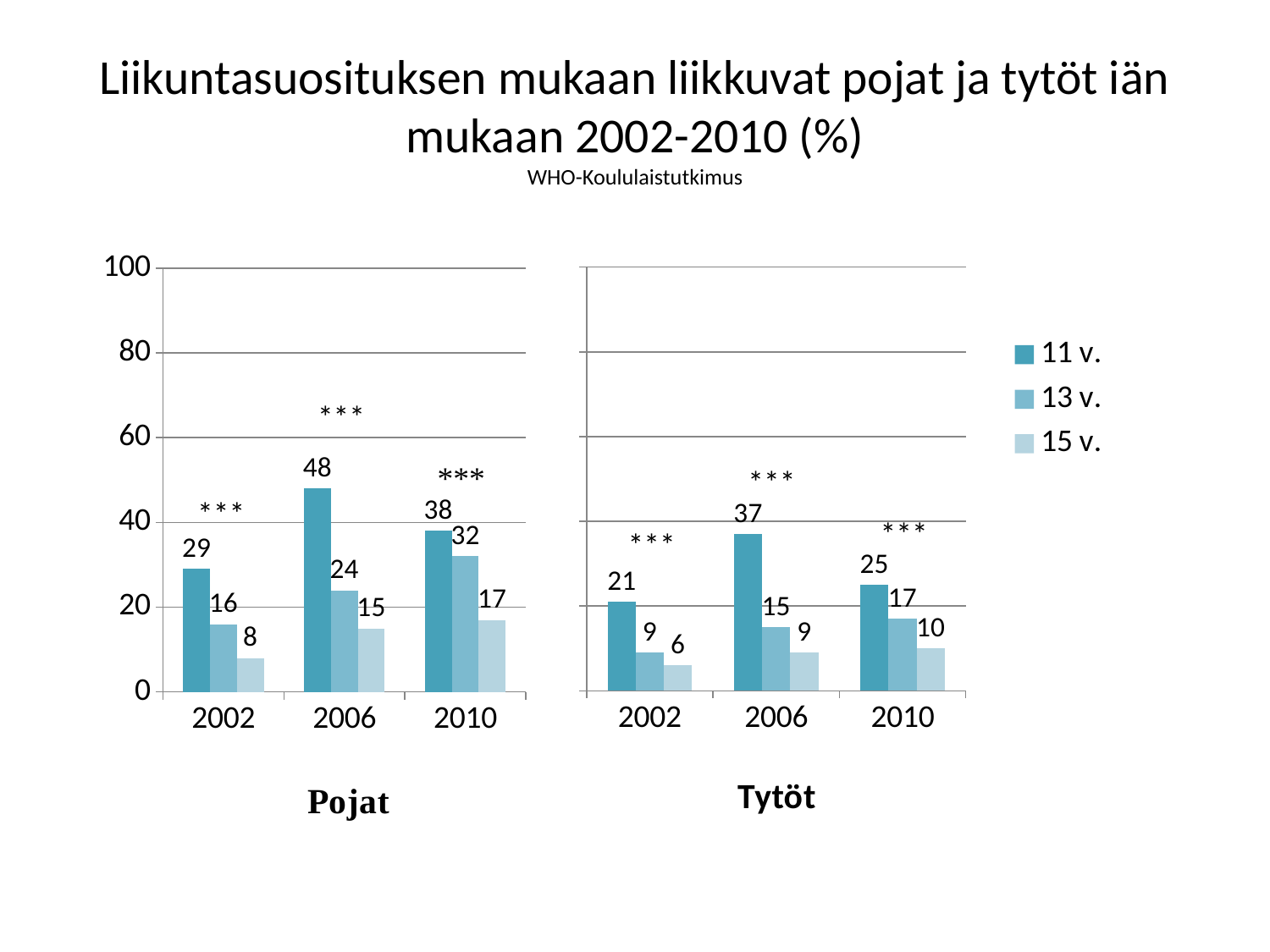
How many years are shown on the x axis of the Pojat chart? 3 Which is larger: the 13 v. value for 2010 in the Pojat chart or the 11 v. value for 2010 in the Tytöt chart? Pojat 13 v. 2010 In the Pojat chart, what is the value for 13 v. in 2010? 32 In the Pojat chart, what is the difference between the 11 v. and 15 v. values in 2010? 21 In the Tytöt chart, does the 13 v. value rise or fall from 2002 to 2010? Rises In the Pojat chart, which year has the lowest value for 15 v.? 2002 In the Tytöt chart, what is the value for 15 v. in 2002? 6 In the Tytöt chart, which year has the highest value for 11 v.? 2006 In the Pojat chart, what is the value for 11 v. in 2006? 48 How many series does the legend list? 3 In the Tytöt chart, what is the difference between the 11 v. values in 2006 and 2002? 16 What type of chart is used on this slide? Bar chart